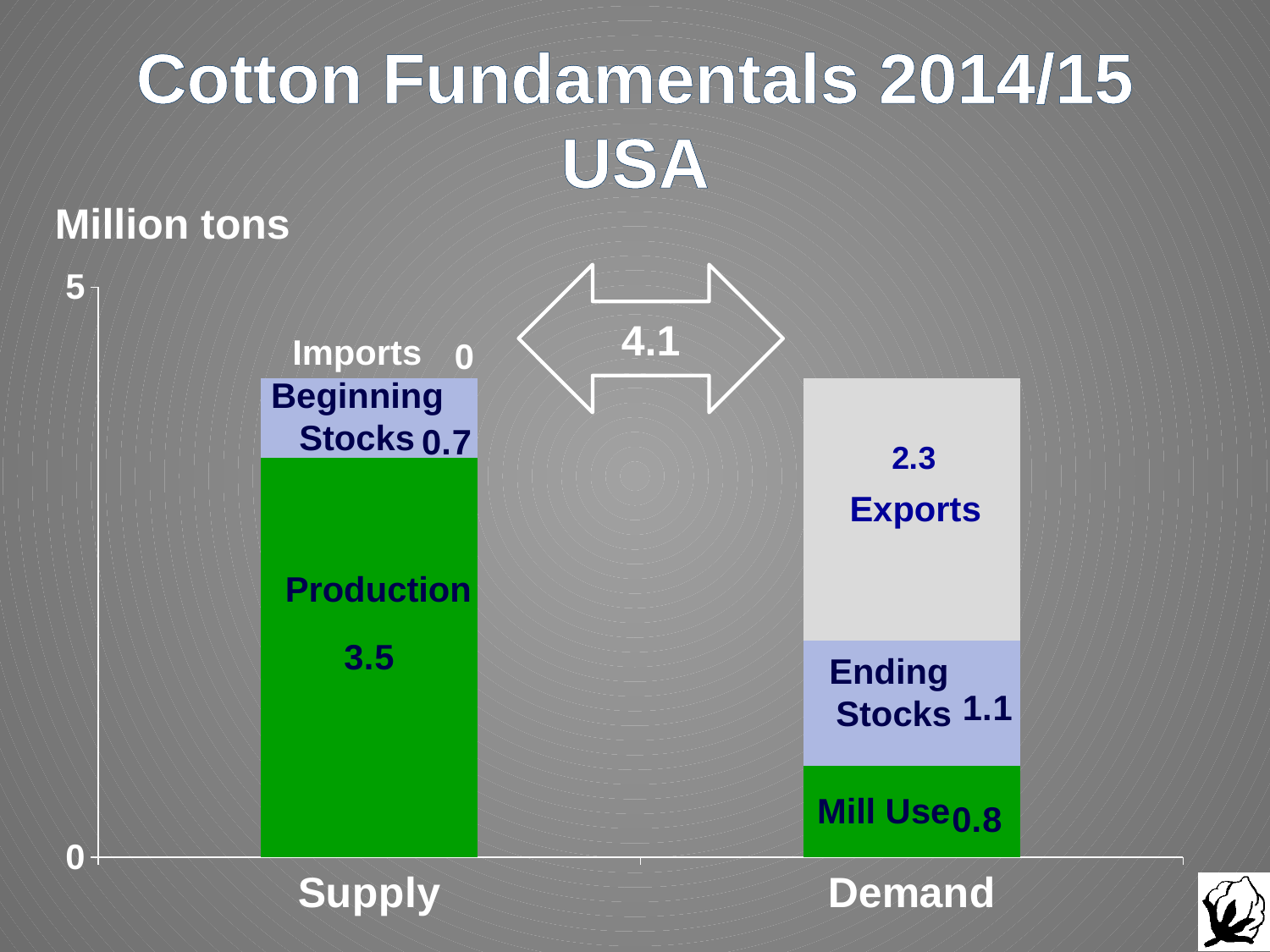
What is the total of the Supply bar? 4.1 What is the value of Ending Stocks in the Demand bar? 1.1 What is the value of Production in the Supply bar? 3.5 What is the value of Exports in the Demand bar? 2.3 What is the value of Imports in the Supply bar? 0 What kind of chart is shown on the slide? Stacked bar chart Which segment of the Demand bar is the smallest? Mill Use Which segment of the Demand bar is the largest? Exports What is the difference between Exports and Mill Use in the Demand bar? 1.5 What is the value of Beginning Stocks in the Supply bar? 0.7 What is the value of Mill Use in the Demand bar? 0.8 Which is larger, Ending Stocks or Beginning Stocks? Ending Stocks